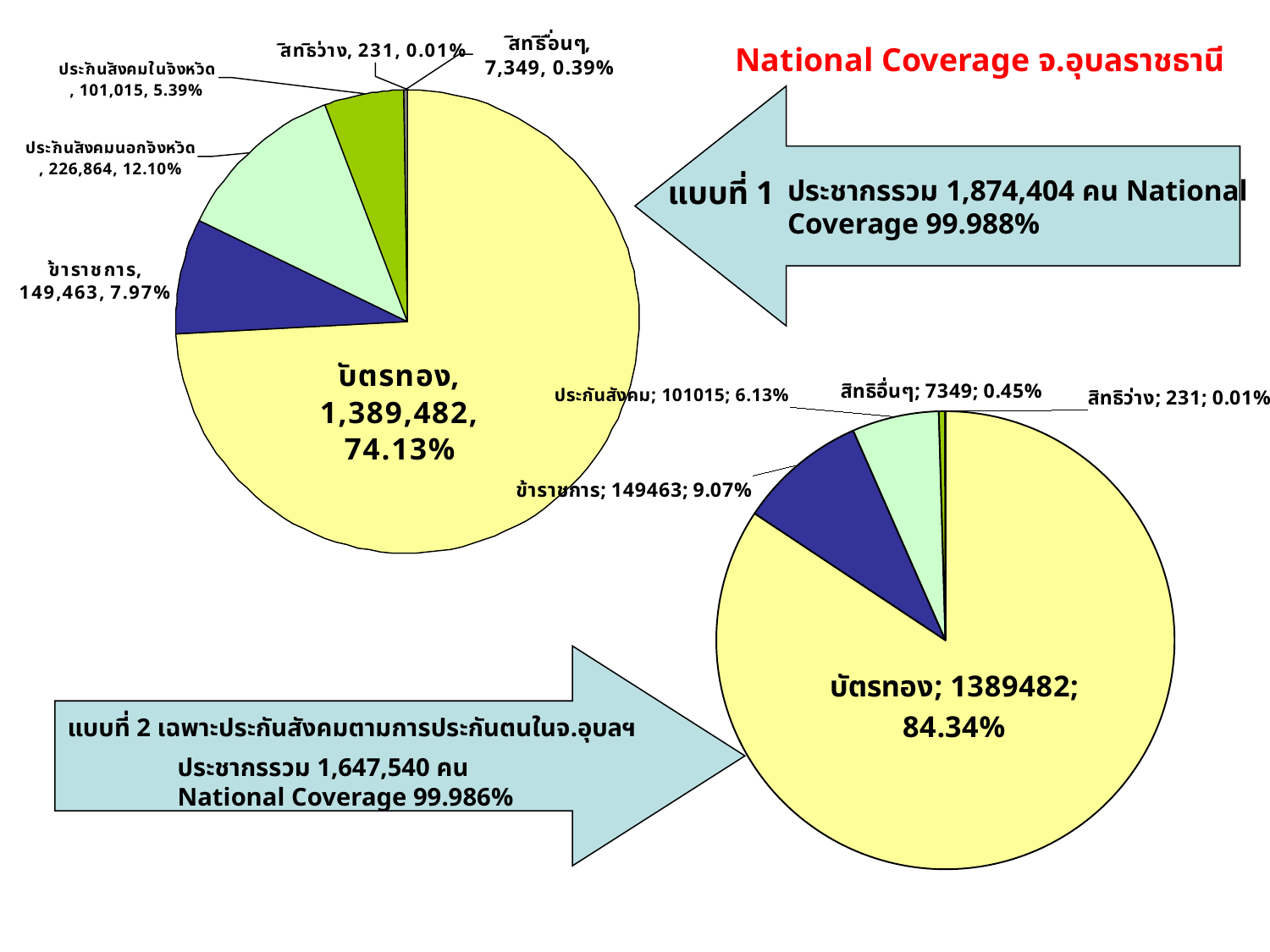
In the bottom-right pie chart, what percentage share does บัตรทอง have? 84.34% In the bottom-right pie chart, what value is shown for ประกันสังคม? 101015 In the top-left pie chart, what value is shown for บัตรทอง? 1,389,482 How many slices does the bottom-right pie chart have? 5 In the bottom-right pie chart, which category has the largest slice? บัตรทอง How many slices does the top-left pie chart have? 6 In the top-left pie chart, what percentage share does ประกันสังคมนอกจังหวัด have? 12.10% In the top-left pie chart, which category has the smallest slice? สิทธิว่าง In the top-left pie chart, what value is shown for ข้าราชการ? 149,463 In the top-left pie chart, which is larger: ประกันสังคมในจังหวัด or ข้าราชการ? ข้าราชการ In the bottom-right pie chart, what is the difference between the values for ข้าราชการ and ประกันสังคม? 48448 What type of chart is the top-left chart on the slide? pie chart